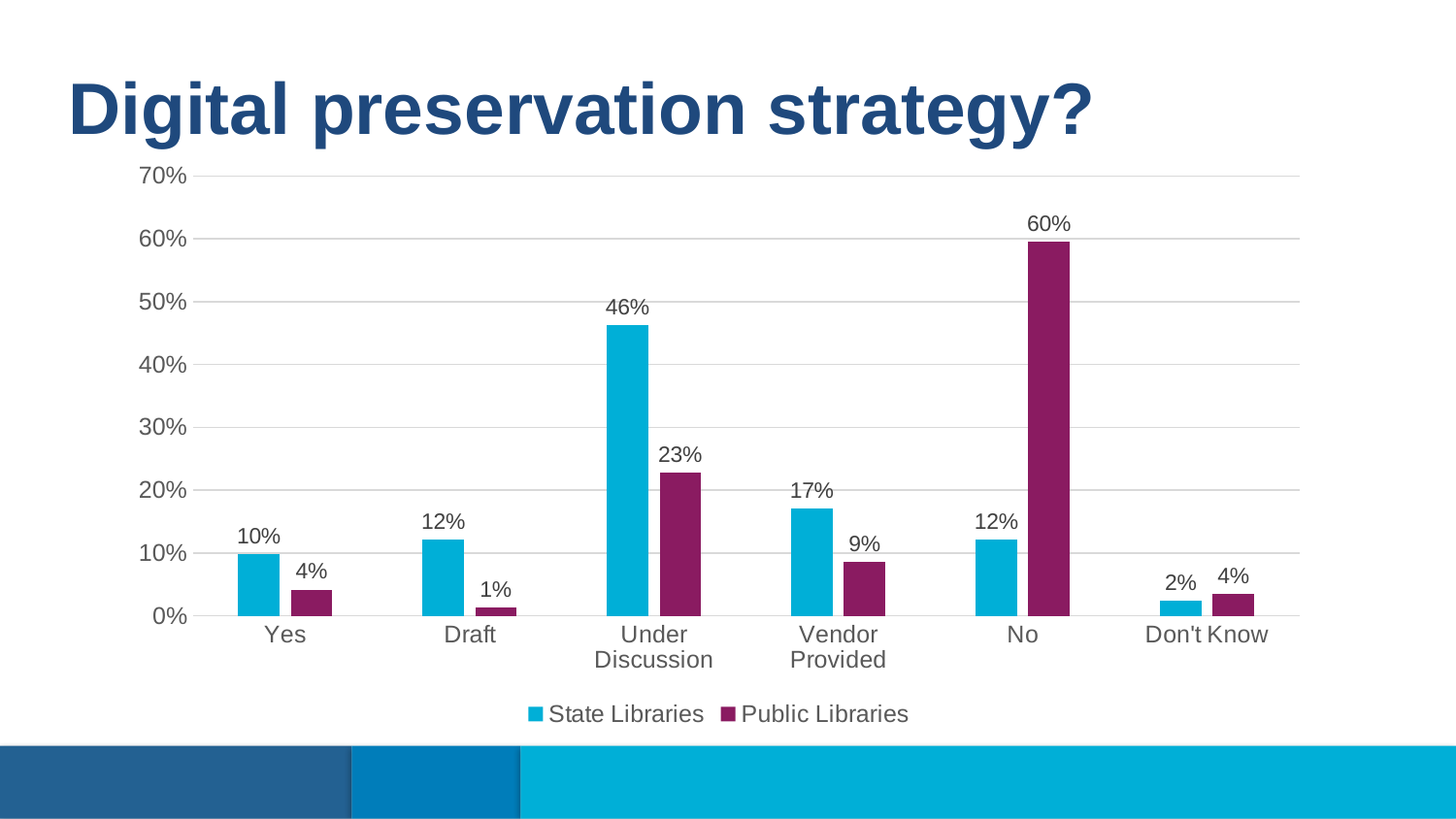
Is the value for Public Libraries in the No category greater or less than 50%? greater What is the value for Public Libraries in the Draft category? 1% How many categories are shown on the x axis? 6 Which category has the highest value for State Libraries? Under Discussion What is the title of the slide? Digital preservation strategy? Which is larger in the Vendor Provided category, State Libraries or Public Libraries? State Libraries What is the difference between State Libraries and Public Libraries in the Under Discussion category? 23% Which category has the lowest value for Public Libraries? Draft How many series does the legend list? 2 What is the value for Public Libraries in the No category? 60% What kind of chart is shown on the slide? Bar chart What is the value for State Libraries in the Under Discussion category? 46%